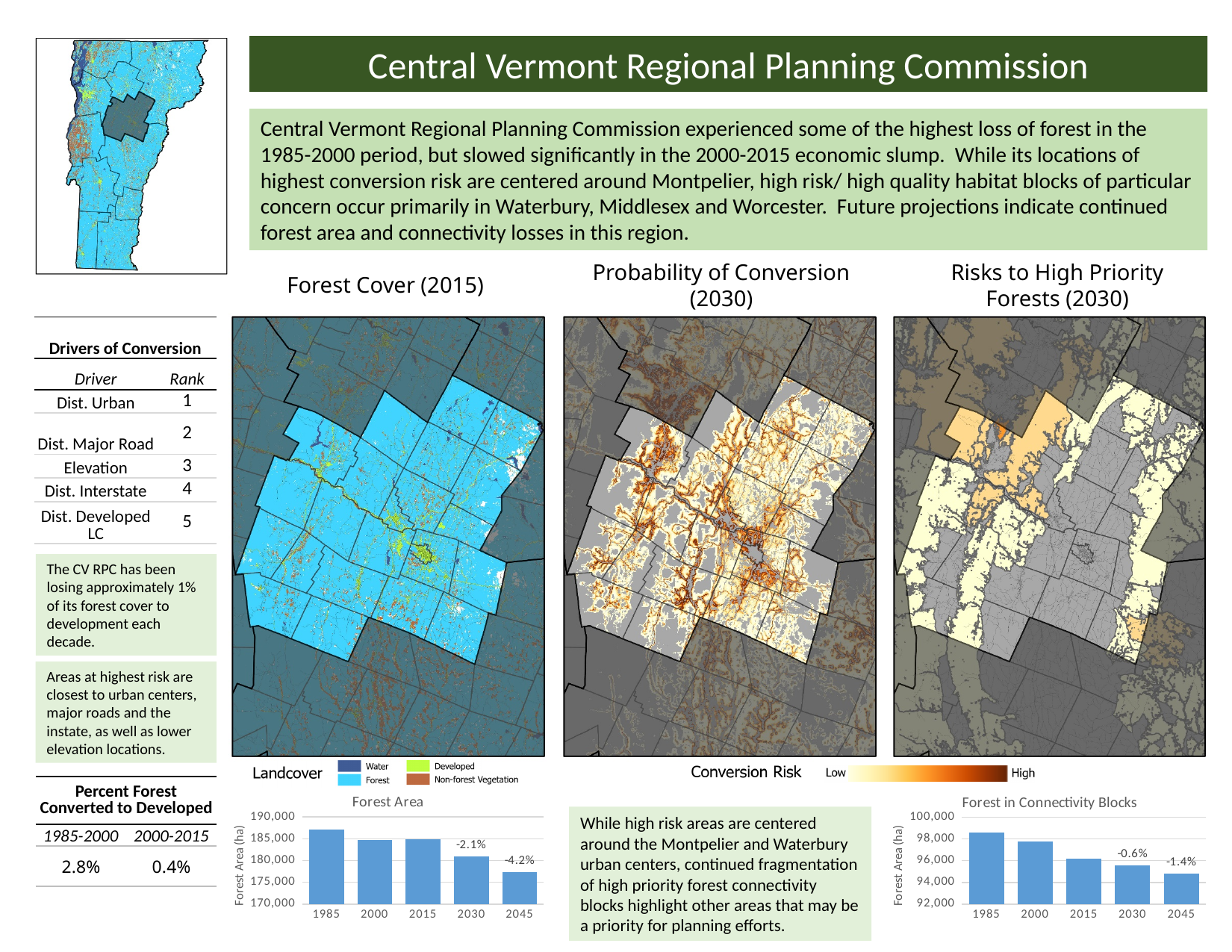
In the "Forest in Connectivity Blocks" chart, is the value for 1985 greater or less than 98,000? greater In the "Forest Area" chart, what percentage change label is shown on the 2045 bar? -4.2% In the "Forest in Connectivity Blocks" chart, which is larger, the value for 2000 or the value for 2045? 2000 In the "Forest Area" chart, is the value for 2045 greater or less than 180,000? less What type of chart is the "Forest Area" chart? bar chart In the "Forest Area" chart, what percentage change label is shown on the 2030 bar? -2.1% In the "Forest Area" chart, how many years are shown on the x axis? 5 In the "Forest Area" chart, which year has the lowest forest area? 2045 In the "Forest Area" chart, which year has the highest forest area? 1985 In the "Forest Area" chart, do the values rise or fall from 1985 to 2045? fall In the "Forest Area" chart, is the value for 1985 greater or less than 185,000? greater In the "Forest in Connectivity Blocks" chart, what percentage change label is shown on the 2045 bar? -1.4%